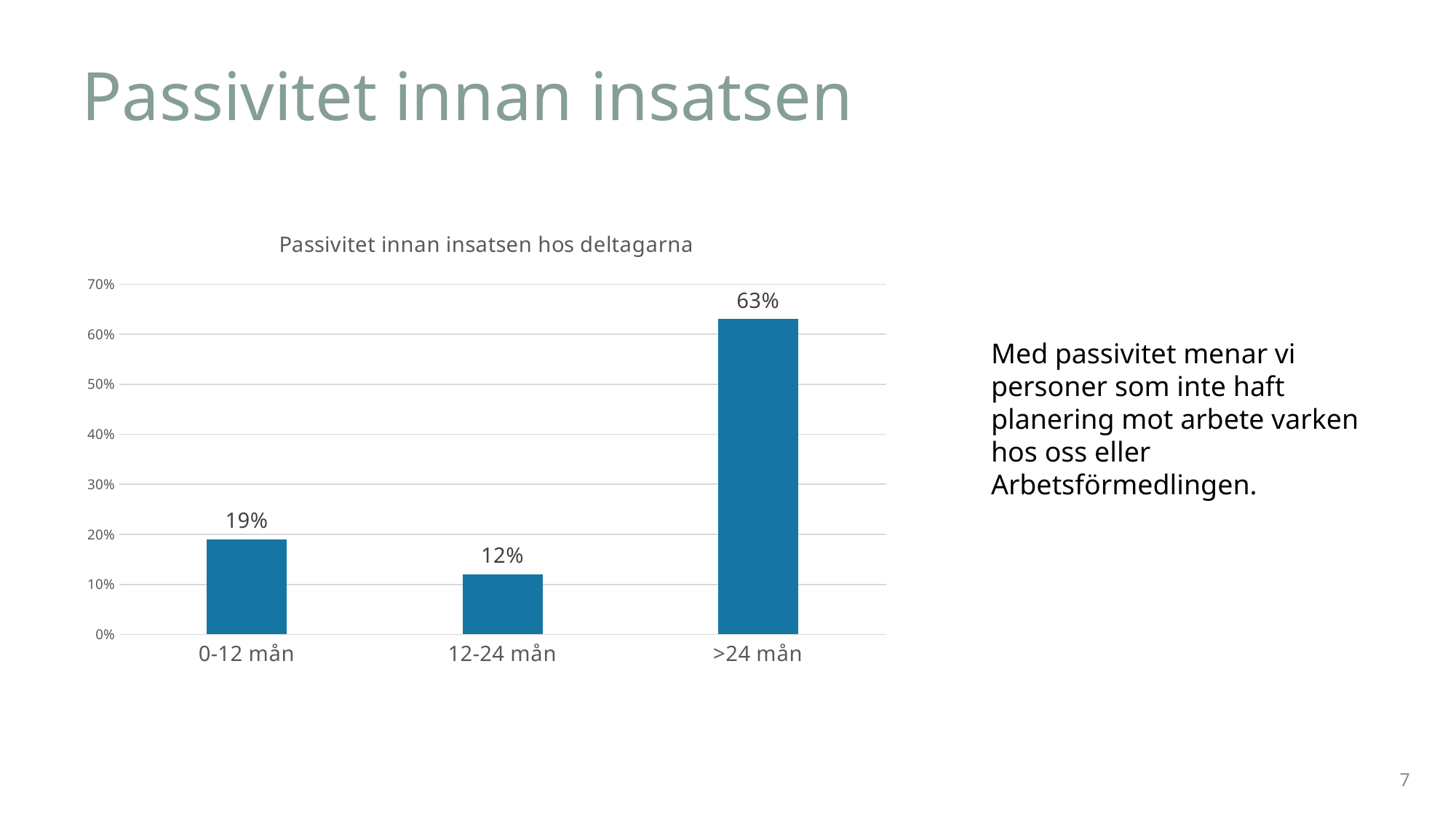
Is the value for >24 mån greater or less than 60%? greater What is the value for 0-12 mån? 19% How many categories are shown on the x axis? 3 Which category has the highest value? >24 mån Which is larger, the value for 0-12 mån or the value for 12-24 mån? 0-12 mån What is the value for >24 mån? 63% What kind of chart is shown on the slide? bar chart What is the difference between the values for >24 mån and 0-12 mån? 44% What is the title of the chart? Passivitet innan insatsen hos deltagarna Which category has the lowest value? 12-24 mån What is the value for 12-24 mån? 12% What is the difference between the values for 0-12 mån and 12-24 mån? 7%